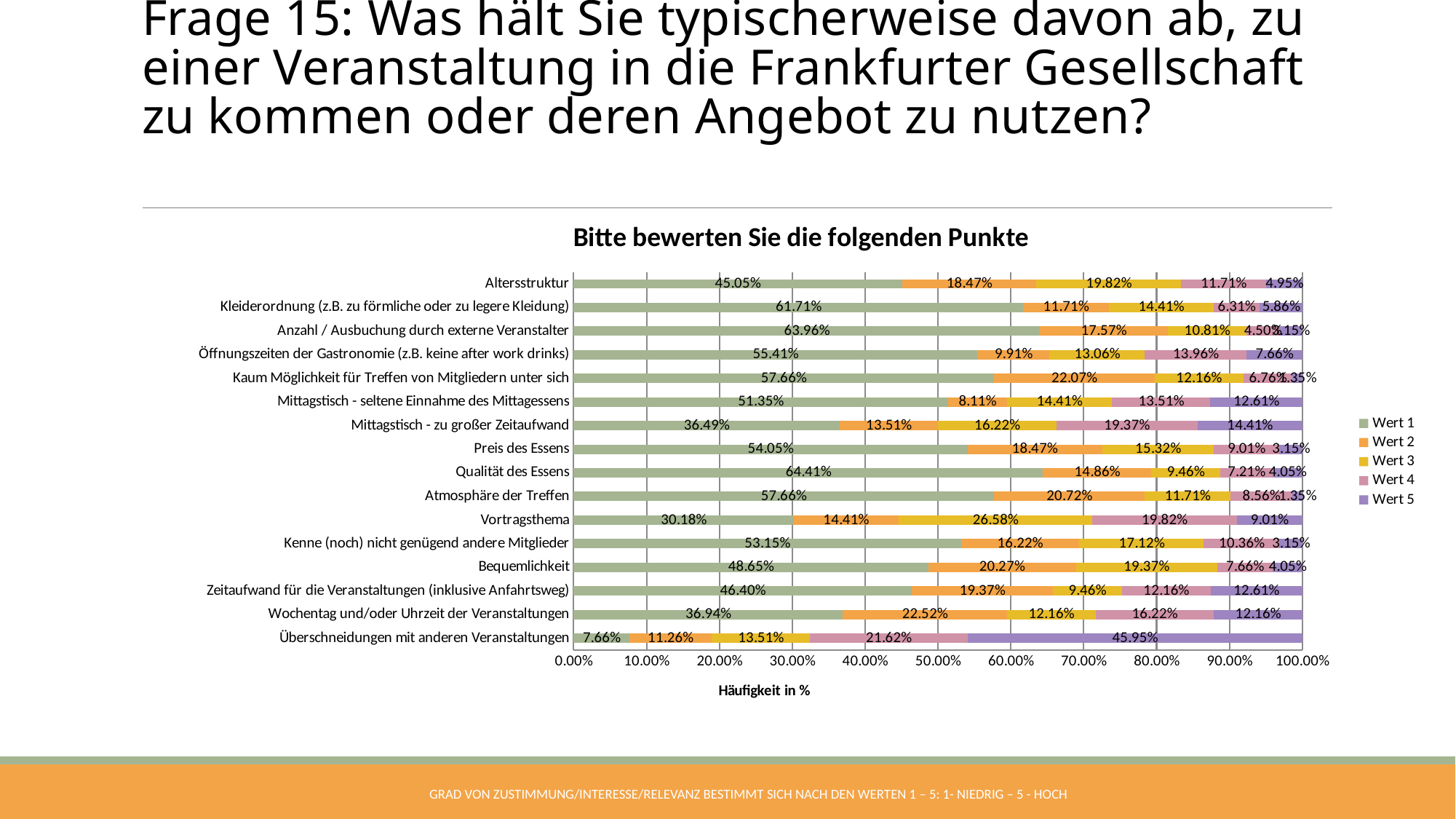
What is the difference between the Wert 1 and Wert 2 values for Altersstruktur? 26.58% What is the Wert 5 value for Überschneidungen mit anderen Veranstaltungen? 45.95% What is the title of the chart? Bitte bewerten Sie die folgenden Punkte Which category has the highest Wert 1 value? Qualität des Essens What is the Wert 3 value for Vortragsthema? 26.58% How many categories are plotted on the chart? 16 What kind of chart is shown on the slide? Stacked horizontal bar chart What is the Wert 2 value for Wochentag und/oder Uhrzeit der Veranstaltungen? 22.52% Which category has the lowest Wert 1 value? Überschneidungen mit anderen Veranstaltungen What is the Wert 1 value for Altersstruktur? 45.05% How many series does the legend list? 5 Which is larger for Mittagstisch - zu großer Zeitaufwand: the Wert 4 value or the Wert 5 value? Wert 4